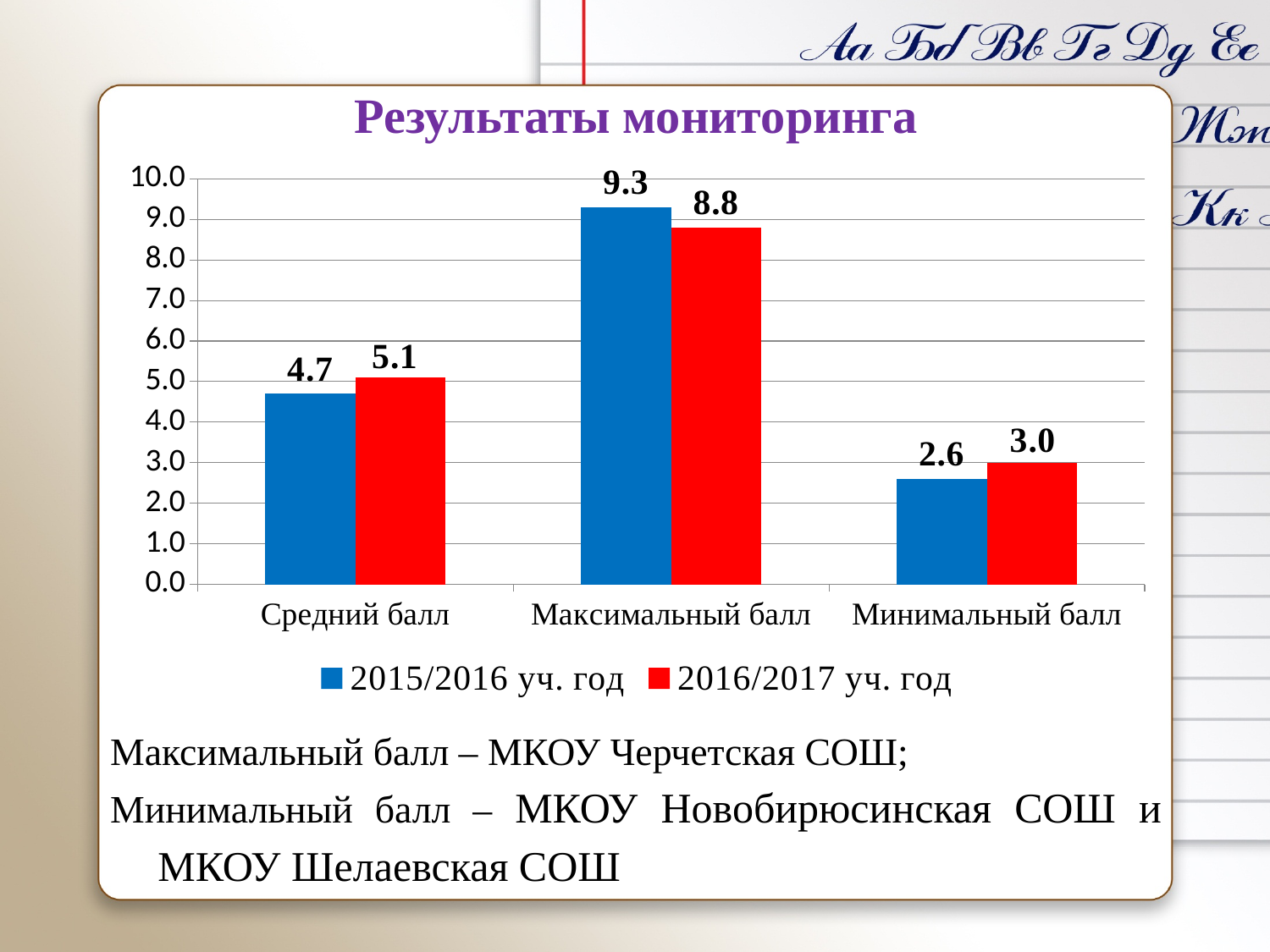
How many categories are shown on the x axis? 3 What is the value for Минимальный балл in the 2016/2017 уч. год series? 3.0 How many series does the legend list? 2 Which category has the lowest value in the 2016/2017 уч. год series? Минимальный балл What is the value for Максимальный балл in the 2016/2017 уч. год series? 8.8 Is the value for Минимальный балл in the 2015/2016 уч. год series greater or less than 3.0? less Which category has the highest value in the 2015/2016 уч. год series? Максимальный балл What is the difference between the 2015/2016 уч. год and 2016/2017 уч. год values for Максимальный балл? 0.5 What is the value for Средний балл in the 2015/2016 уч. год series? 4.7 What kind of chart is shown on the slide? bar chart For Средний балл, which series has the larger value: 2015/2016 уч. год or 2016/2017 уч. год? 2016/2017 уч. год What is the title of the chart? Результаты мониторинга